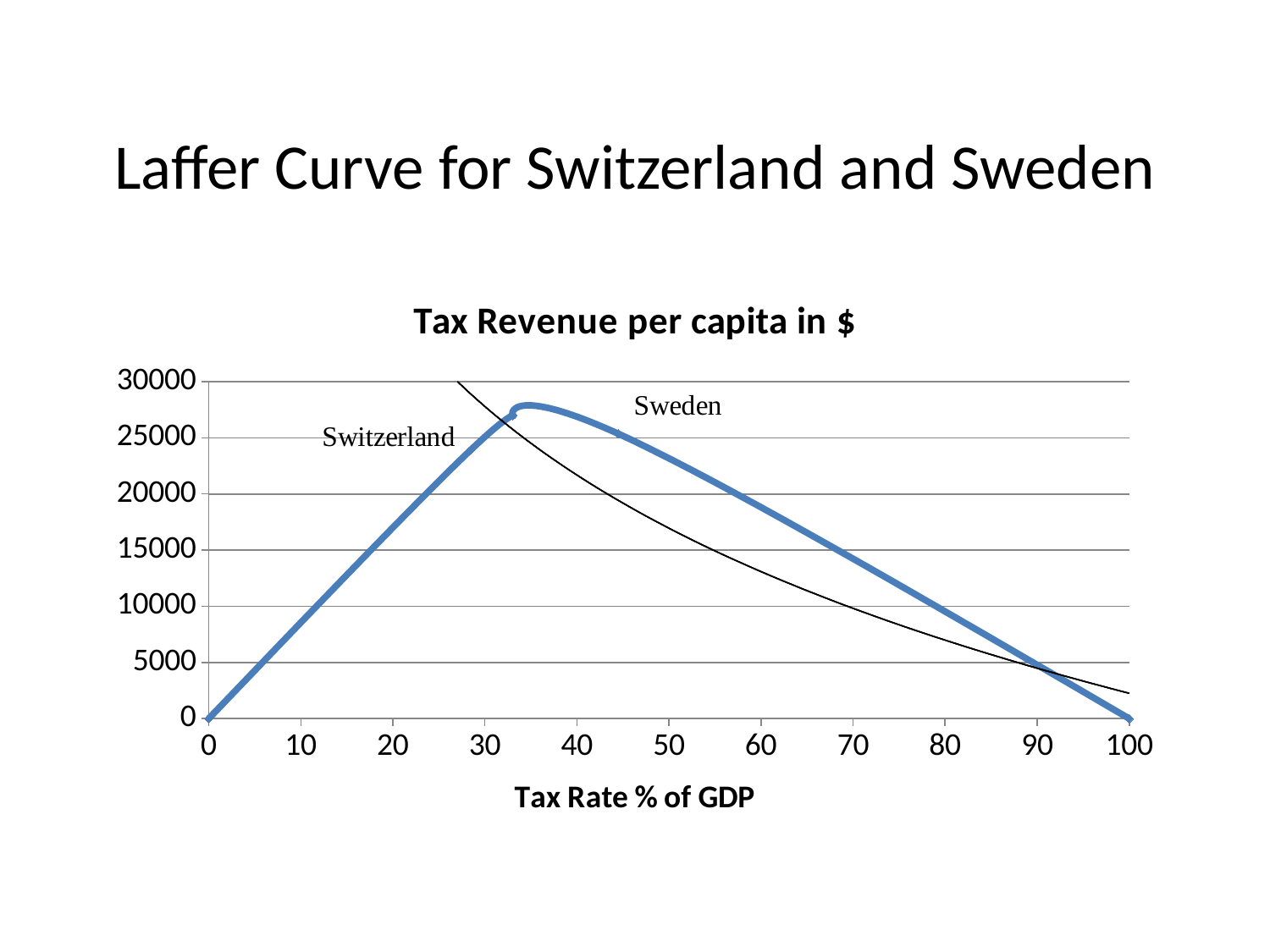
Do the values of the thick blue curve rise or fall as the tax rate increases from 0 to 30? rise What kind of chart is shown on the slide? line chart What is the x-axis title of the chart? Tax Rate % of GDP Is the value of the thick blue curve higher at a tax rate of 40 or at a tax rate of 80? 40 What is the tax revenue per capita at a tax rate of 100% of GDP? 0 Is the value of the thick blue curve at a tax rate of 10 greater or less than 5000? greater Is the value of the thick blue curve at a tax rate of 50 greater or less than 20000? greater Is the value of the thick blue curve at a tax rate of 30 greater or less than 20000? greater What is the title of the chart? Tax Revenue per capita in $ What is the tax revenue per capita at a tax rate of 0% of GDP? 0 Do the values of the thick blue curve rise or fall as the tax rate increases from 40 to 100? fall